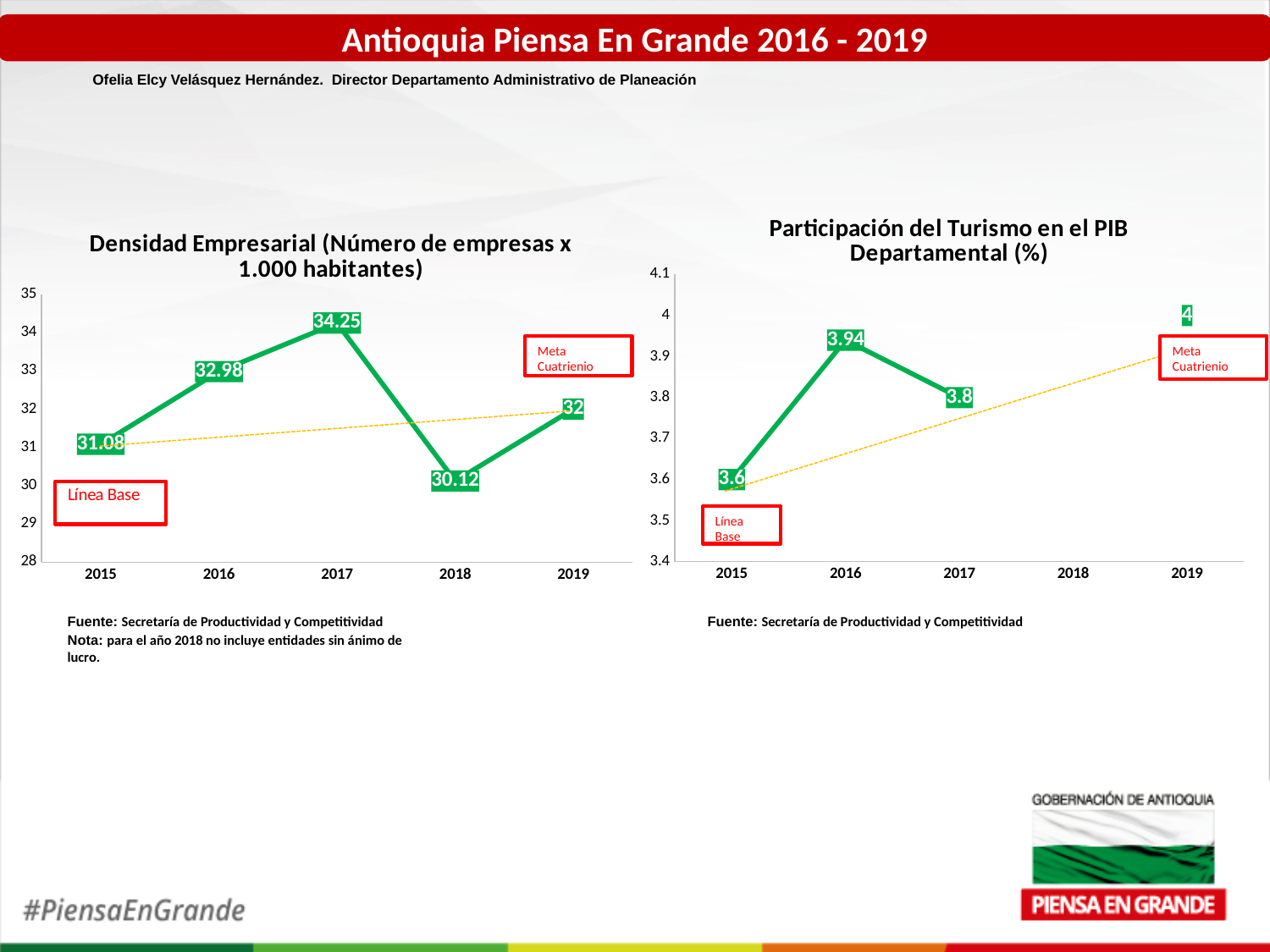
In the 'Participación del Turismo en el PIB Departamental (%)' chart, what is the difference between the 2019 value and the 2015 value? 0.4 In the 'Densidad Empresarial' chart, which year has the highest value? 2017 In the 'Densidad Empresarial' chart, what is the value for 2017? 34.25 How many years are shown on the x axis of the 'Participación del Turismo en el PIB Departamental (%)' chart? 5 In the 'Densidad Empresarial' chart, what is the difference between the 2017 value and the 2015 value? 3.17 In the 'Densidad Empresarial' chart, which year has the lowest value? 2018 In the 'Densidad Empresarial' chart, is the value for 2016 greater or less than 32? greater In the 'Participación del Turismo en el PIB Departamental (%)' chart, which is larger, the value for 2016 or the value for 2017? 2016 What type of chart is the 'Densidad Empresarial' chart? Line chart In the 'Participación del Turismo en el PIB Departamental (%)' chart, what is the value for 2015? 3.6 In the 'Densidad Empresarial' chart, what is the value for 2018? 30.12 In the 'Participación del Turismo en el PIB Departamental (%)' chart, what is the value for 2016? 3.94